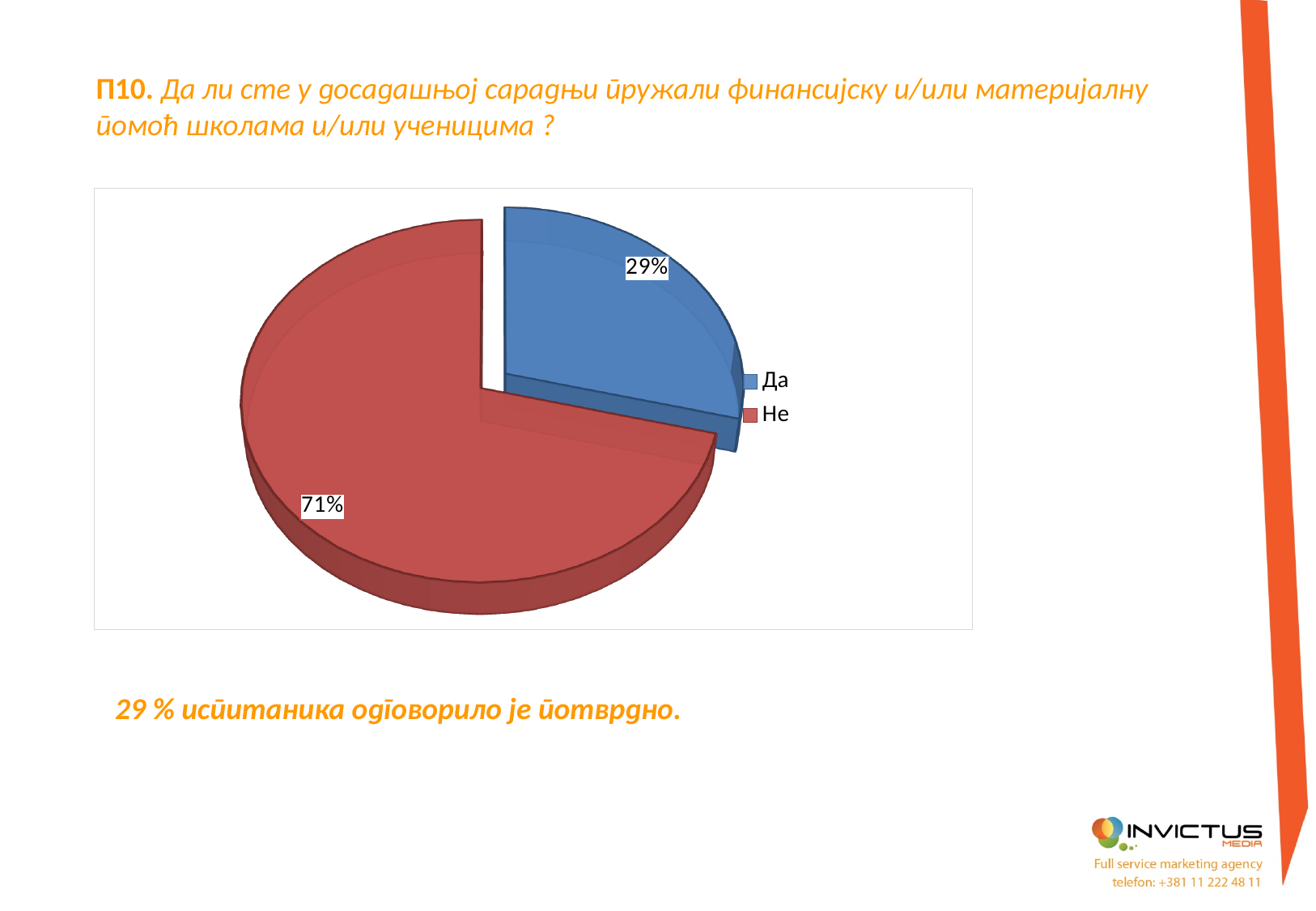
What colour is the "Да" slice? Blue Is the share of the "Да" slice greater or less than 50%? less What share of the pie does the "Не" slice represent? 71% What is the difference in percentage points between the "Не" and "Да" slices? 42 What colour is the "Не" slice? Red Which slice is the smallest in the pie chart? Да How many entries does the legend list? 2 What kind of chart is shown on the slide? Pie chart Which slice is the largest in the pie chart? Не How many slices does the pie chart have? 2 What share of the pie does the "Да" slice represent? 29% Which is larger, the "Да" slice or the "Не" slice? Не